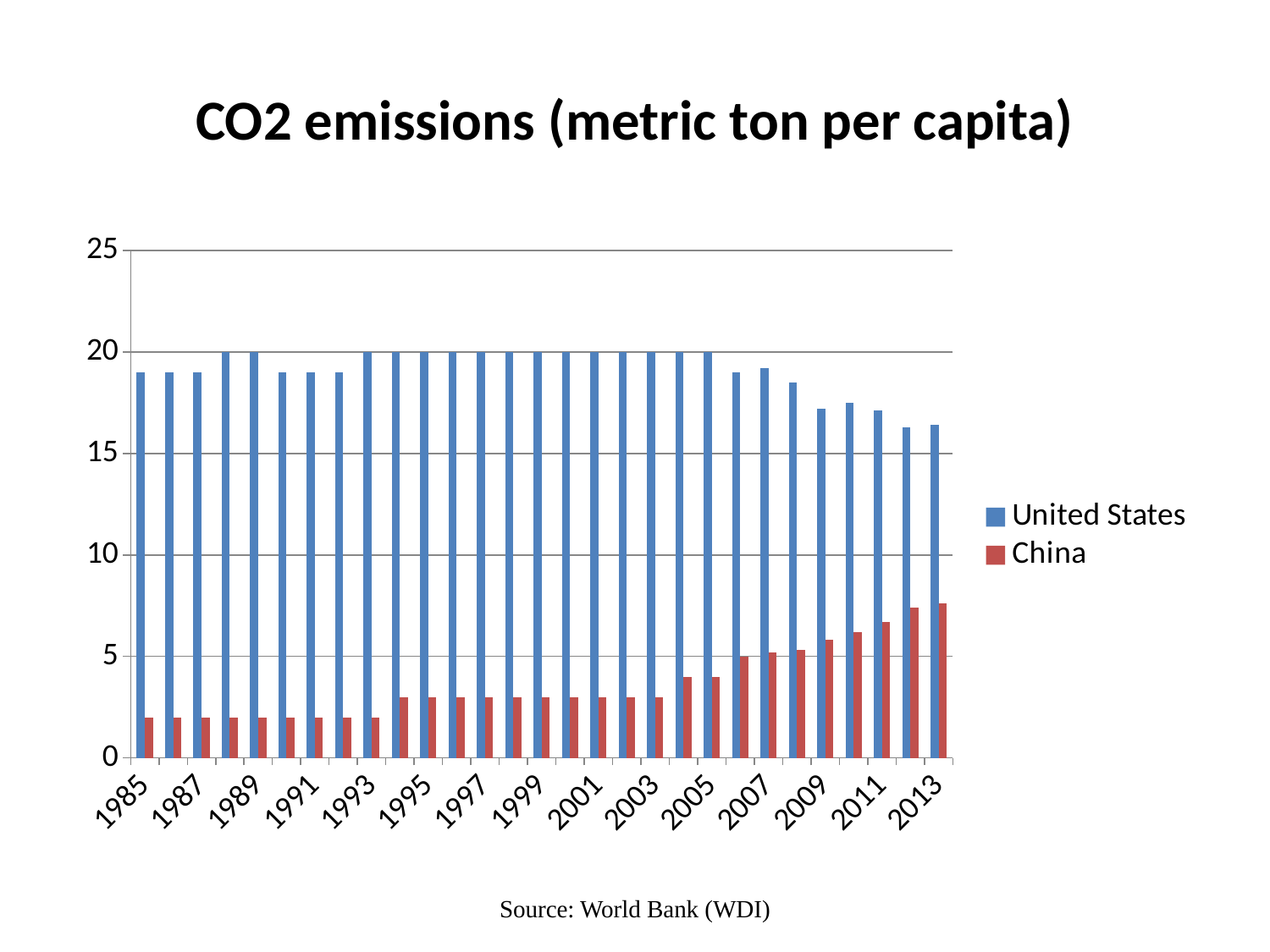
Do the values for China rise or fall from 1985 to 2013? rise How many series does the legend list? 2 In 2013, which series has the larger value, United States or China? United States Which two series are listed in the legend? United States and China Is the value for the United States in 1985 greater or less than 15? greater Is the value for the United States in 2013 greater or less than 20? less What is the title of the chart? CO2 emissions (metric ton per capita) Is the value for China in 2013 greater or less than 5? greater Do the values for the United States rise or fall from 2005 to 2013? fall What kind of chart is shown on the slide? bar chart In which year is the value for China highest? 2013